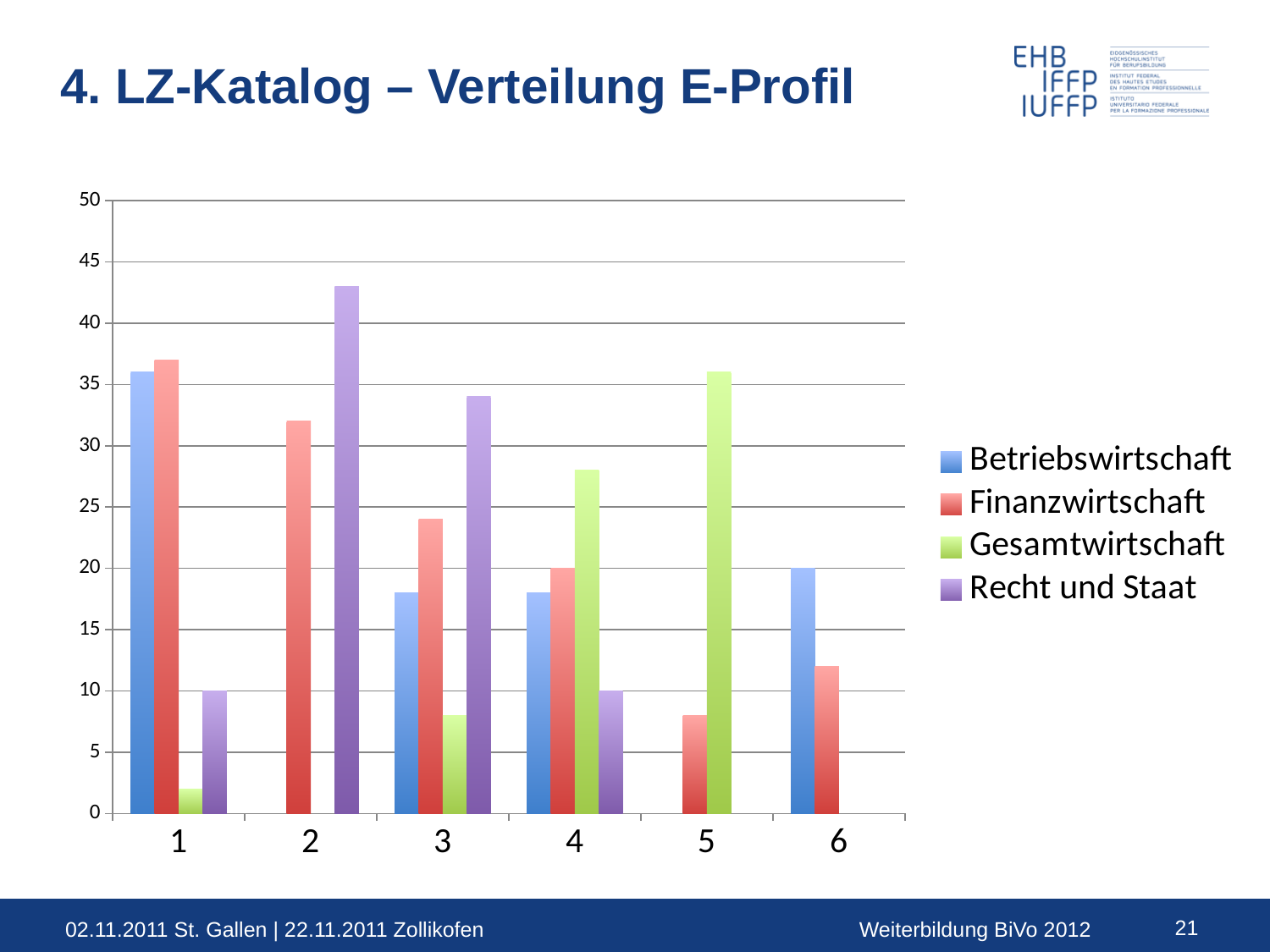
Is the value for Betriebswirtschaft in category 3 greater or less than 20? less Which series is shown in green in the legend? Gesamtwirtschaft Is the value for Recht und Staat in category 2 greater or less than 40? greater In category 3, which is larger: Recht und Staat or Finanzwirtschaft? Recht und Staat Which series has the shortest bar in category 1? Gesamtwirtschaft How many categories are shown on the x axis? 6 Which series and category has the tallest bar in the chart? Recht und Staat, category 2 Is the value for Finanzwirtschaft in category 5 greater or less than 10? less What kind of chart is shown on the slide? bar chart In category 4, which is larger: Gesamtwirtschaft or Betriebswirtschaft? Gesamtwirtschaft How many series does the legend list? 4